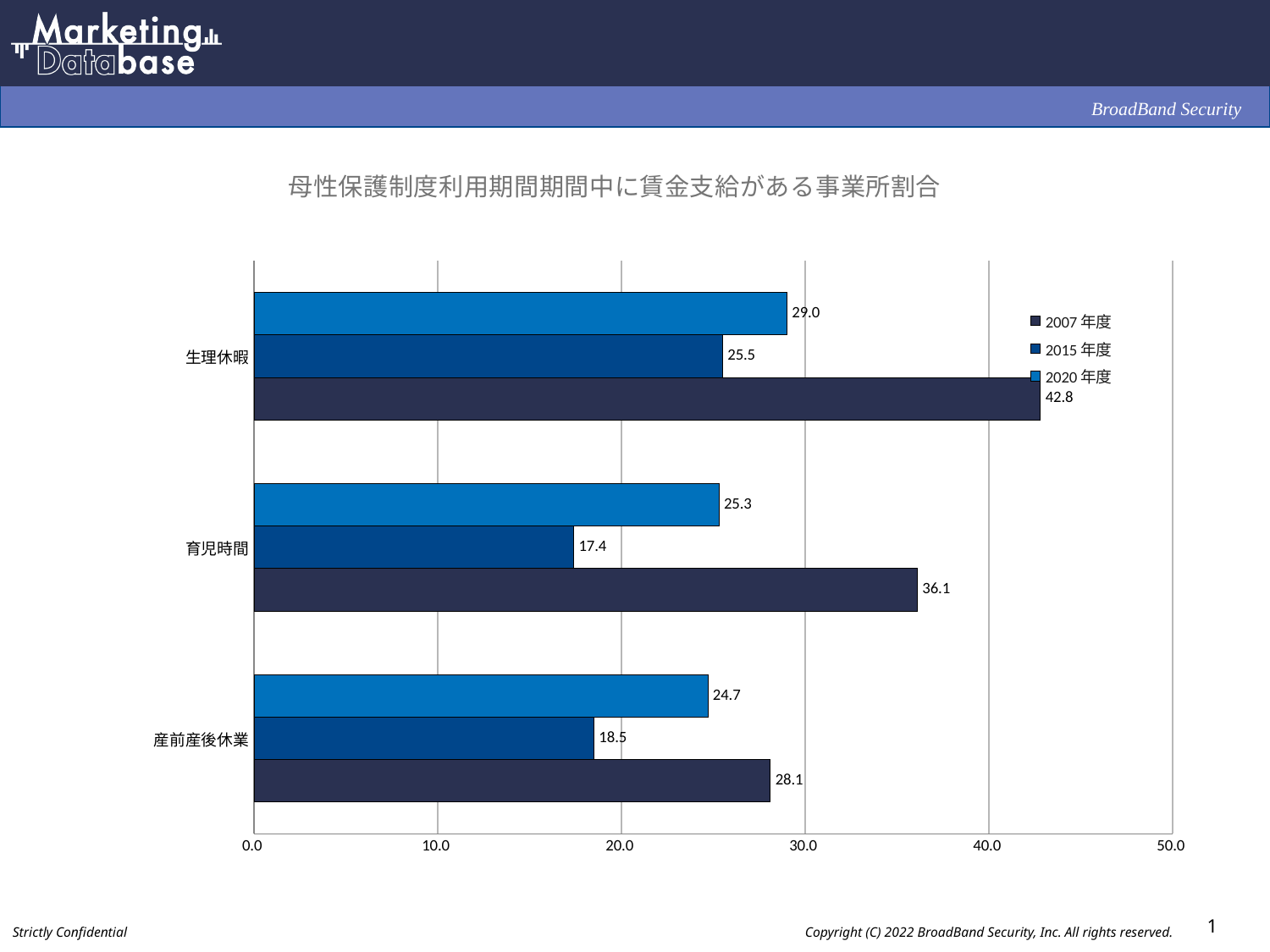
Which category has the lowest value in the 2015 年度 series? 育児時間 Which is larger for 産前産後休業: the 2020 年度 value or the 2015 年度 value? 2020 年度 How many categories are shown on the chart? 3 What is the value for 育児時間 in the 2015 年度 series? 17.4 What is the title of the chart? 母性保護制度利用期間期間中に賃金支給がある事業所割合 What is the value for 産前産後休業 in the 2020 年度 series? 24.7 What is the difference between the 2007 年度 and 2015 年度 values for 育児時間? 18.7 How many series does the legend list? 3 What kind of chart is shown on the slide? Bar chart What is the value for 生理休暇 in the 2007 年度 series? 42.8 Which category has the highest value in the 2007 年度 series? 生理休暇 Is the 2007 年度 value for 生理休暇 greater or less than 40.0? greater